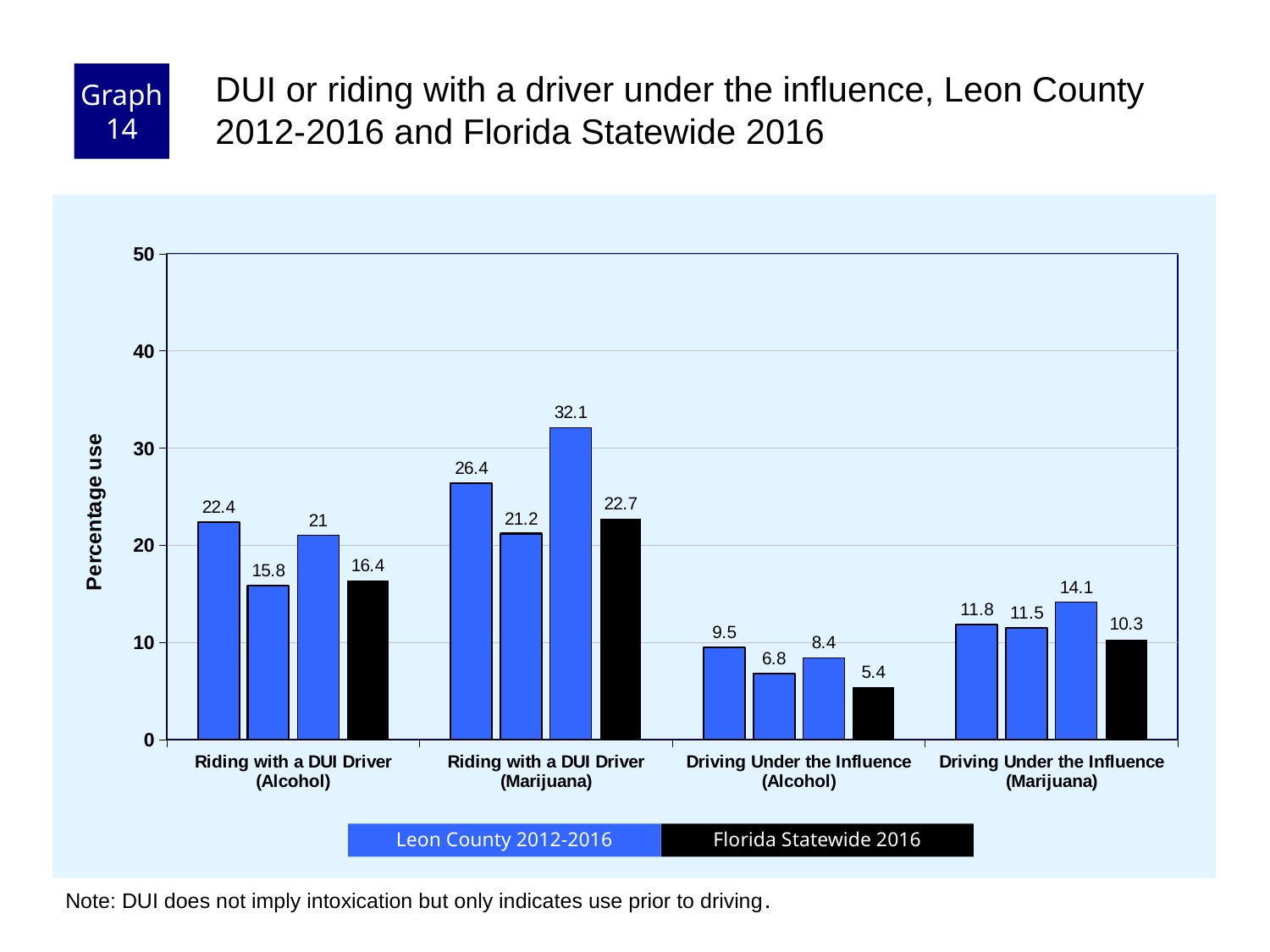
What is the Florida Statewide 2016 value for Riding with a DUI Driver (Alcohol)? 16.4 Which category has the lowest Florida Statewide 2016 value? Driving Under the Influence (Alcohol) What type of chart is shown? Bar chart What is the highest value shown on the chart? 32.1 What is the Florida Statewide 2016 value for Riding with a DUI Driver (Marijuana)? 22.7 Is the Florida Statewide 2016 value for Riding with a DUI Driver (Marijuana) greater or less than 20? greater How many categories are shown on the x axis? 4 Which is larger: the Florida Statewide 2016 value for Driving Under the Influence (Marijuana) or for Driving Under the Influence (Alcohol)? Driving Under the Influence (Marijuana) What is the Florida Statewide 2016 value for Driving Under the Influence (Alcohol)? 5.4 How many series does the legend list? 2 What is the Florida Statewide 2016 value for Driving Under the Influence (Marijuana)? 10.3 What is the difference between the Florida Statewide 2016 values for Riding with a DUI Driver (Marijuana) and Riding with a DUI Driver (Alcohol)? 6.3